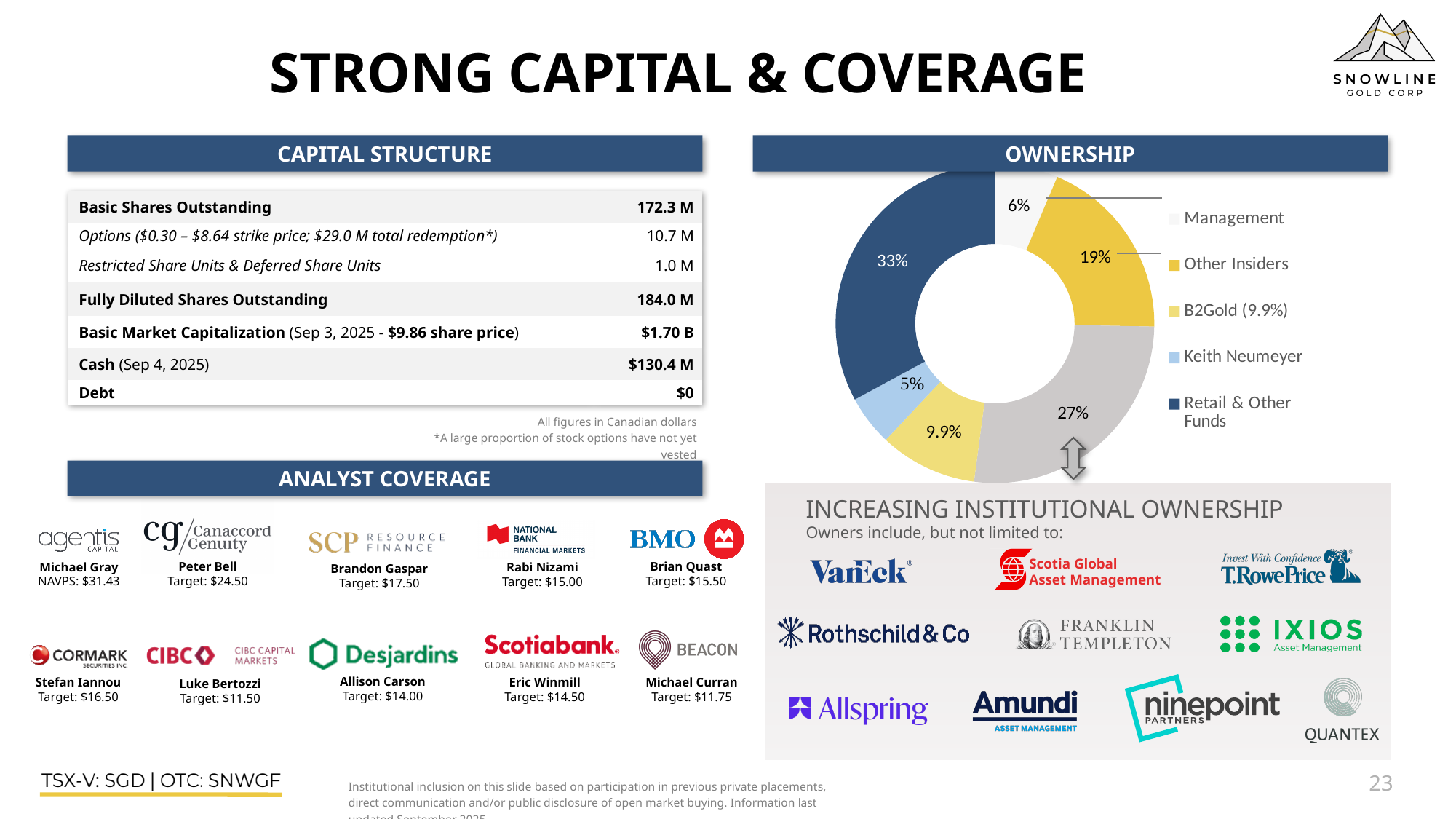
What kind of chart is shown under the OWNERSHIP heading? Pie chart (donut) In the OWNERSHIP chart, which is larger: the B2Gold share or the Keith Neumeyer share? B2Gold In the OWNERSHIP chart, what share is held by B2Gold? 9.9% In the OWNERSHIP chart, what share is held by Keith Neumeyer? 5% In the OWNERSHIP chart, what colour is the Retail & Other Funds slice? Dark blue In the OWNERSHIP chart, what share is held by Management? 6% In the OWNERSHIP chart, how many percentage points larger is the Other Insiders share than the Management share? 13 In the OWNERSHIP chart, what share is held by Other Insiders? 19% In the OWNERSHIP chart, what share is held by Retail & Other Funds? 33% In the OWNERSHIP chart, which legend category holds the smallest share? Keith Neumeyer How many entries does the legend of the OWNERSHIP chart list? 5 In the OWNERSHIP chart, which legend category holds the largest share? Retail & Other Funds